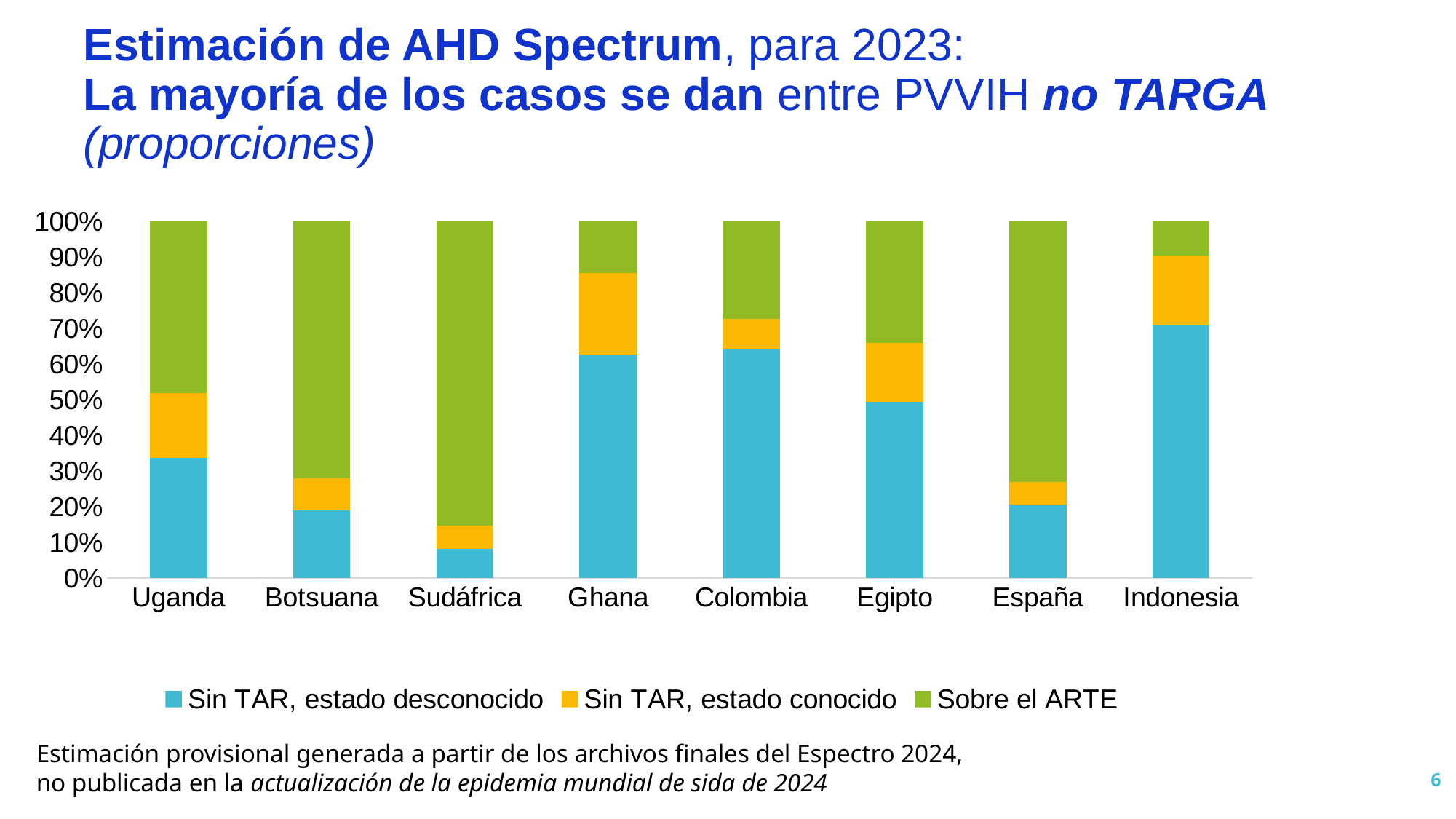
What kind of chart is shown on the slide? Stacked bar chart What is the name of the series shown in green in the legend? Sobre el ARTE Which country has the largest 'Sobre el ARTE' share? Sudáfrica Which has a larger 'Sin TAR, estado desconocido' share, Ghana or Botsuana? Ghana Which country has the smallest 'Sin TAR, estado desconocido' share? Sudáfrica Is the 'Sin TAR, estado desconocido' share for España greater or less than 30%? less Is the 'Sin TAR, estado desconocido' share for Uganda greater or less than 30%? greater Which country has the largest 'Sin TAR, estado desconocido' share? Indonesia How many series does the chart legend list? 3 Is the 'Sin TAR, estado desconocido' share for Sudáfrica greater or less than 20%? less Which has a larger 'Sin TAR, estado desconocido' share, Colombia or Egipto? Colombia How many countries are shown on the x axis of the chart? 8